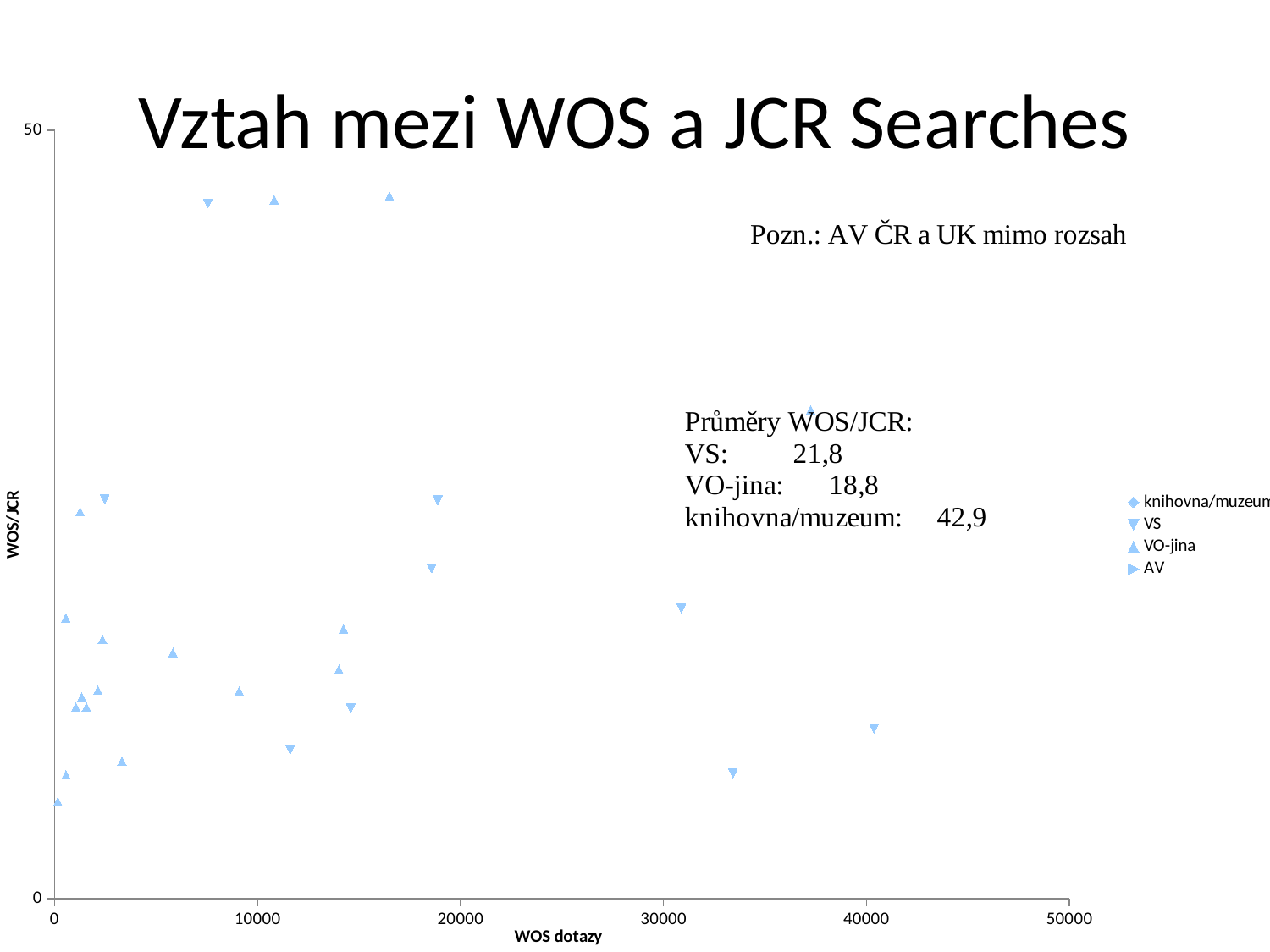
Is the largest WOS dotazy value plotted on the chart greater or less than 50000? less Is the WOS dotazy value of the rightmost VS point greater or less than 30000? greater According to the text on the slide, what is the average WOS/JCR for knihovna/muzeum? 42,9 According to the averages printed on the slide, which group has the highest average WOS/JCR? knihovna/muzeum What is the title of the chart on the slide? Vztah mezi WOS a JCR Searches According to the averages printed on the slide, what is the difference between the VS and VO-jina average WOS/JCR? 3 How many series does the chart legend list? 4 What kind of chart is shown on the slide? scatter chart According to the text on the slide, what is the average WOS/JCR for VS? 21,8 What is the label of the horizontal axis of the chart? WOS dotazy